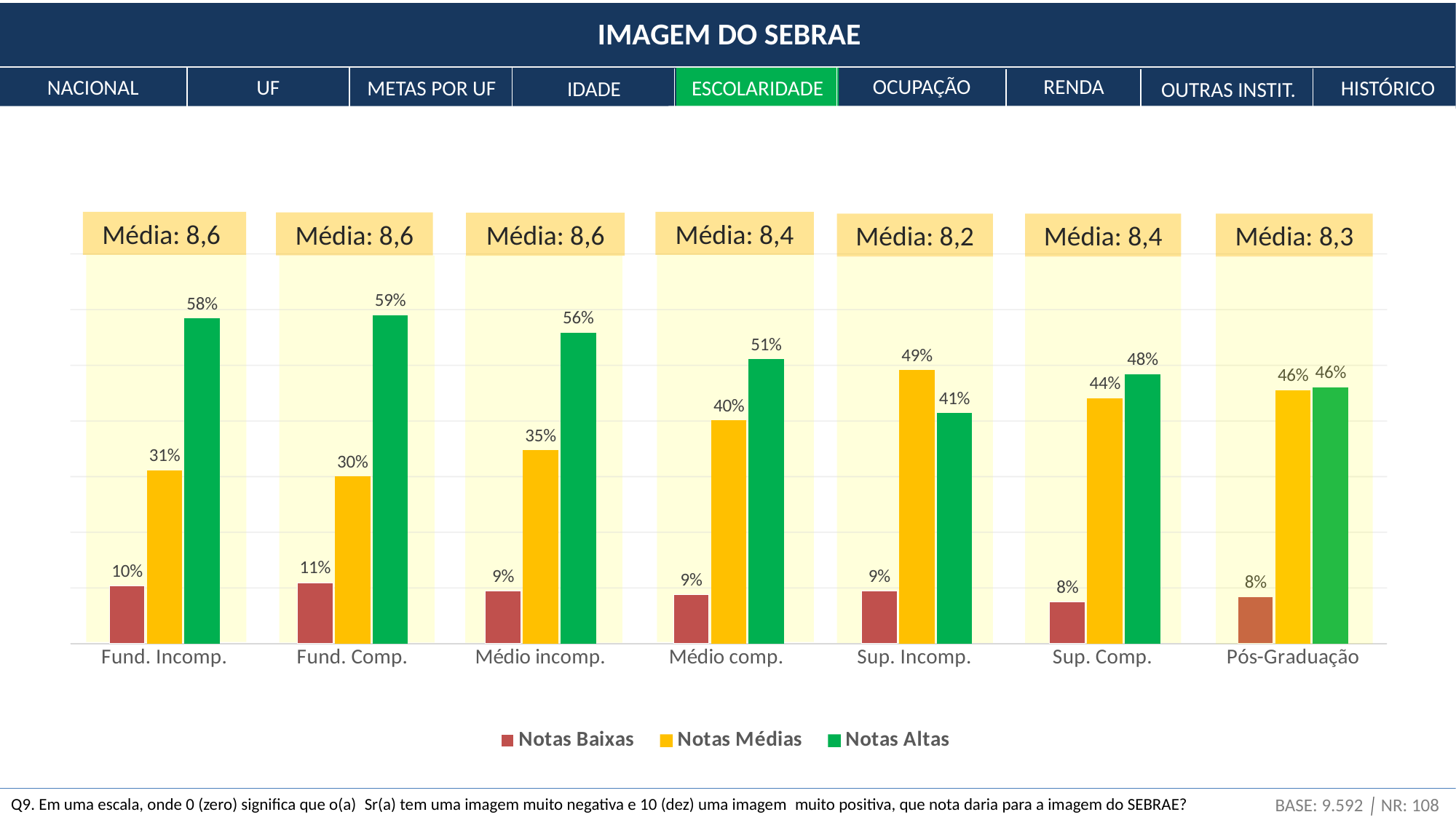
What is the value of Notas Baixas for Pós-Graduação? 8% How many series does the legend list? 3 For Sup. Incomp., which is larger: Notas Médias or Notas Altas? Notas Médias What colour represents Notas Altas in the legend? Green What is the difference between Notas Altas and Notas Médias for Médio comp.? 11% What is the Média shown above the Sup. Incomp. group? 8,2 Which category has the lowest Notas Médias value? Fund. Comp. What kind of chart is shown on the slide? Bar chart What is the value of Notas Altas for Fund. Comp.? 59% Which category has the highest Notas Altas value? Fund. Comp. What is the value of Notas Médias for Sup. Incomp.? 49% How many education categories are shown on the x axis? 7